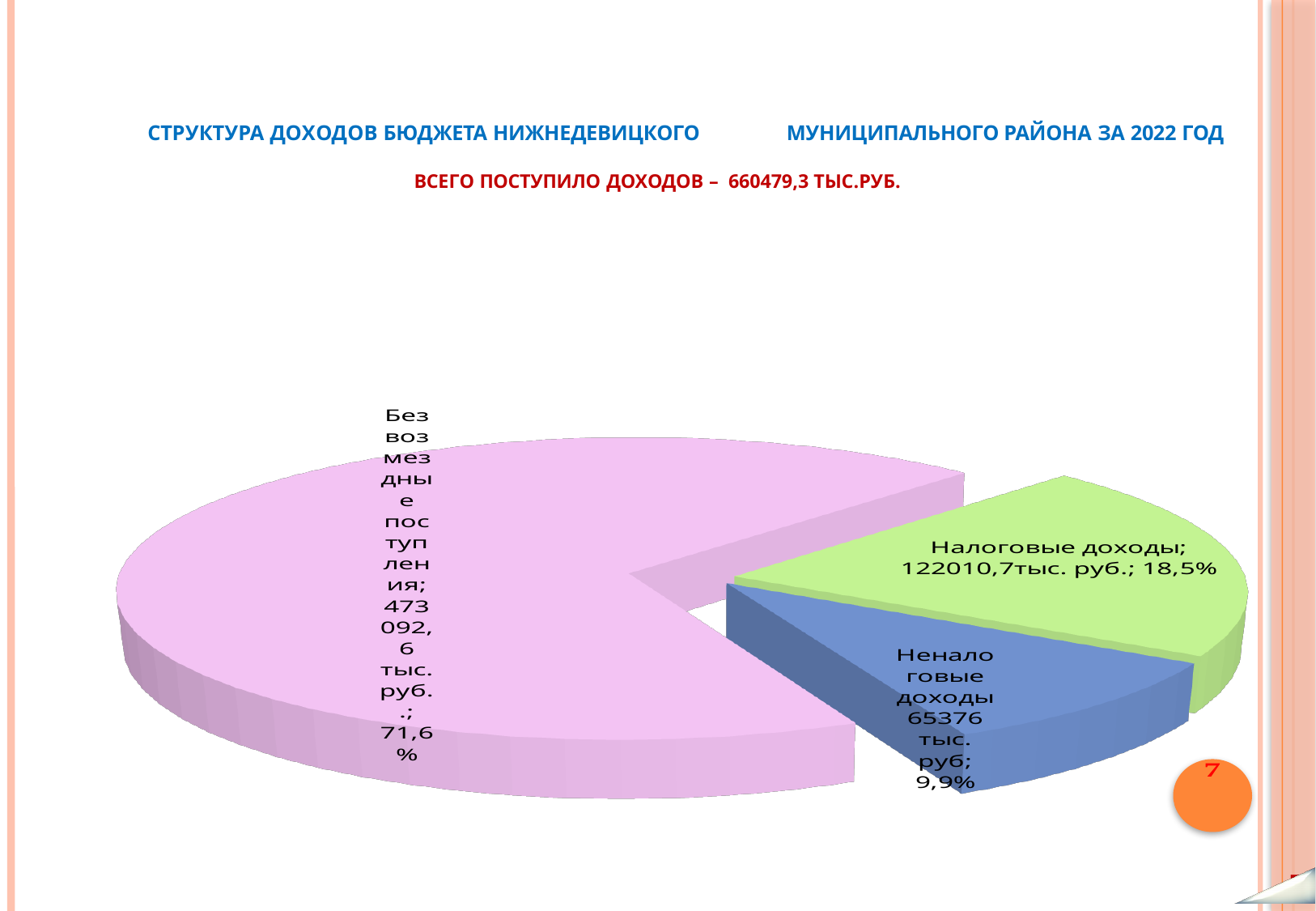
Which slice of the pie chart is the largest? Безвозмездные поступления Which slice of the pie chart is the smallest? Неналоговые доходы What kind of chart is shown on the slide? Pie chart What percentage share is shown for Налоговые доходы? 18,5% How many slices does the pie chart have? 3 What is the value shown for Налоговые доходы? 122010,7 тыс. руб. What percentage share is shown for Неналоговые доходы? 9,9% What percentage share is shown for Безвозмездные поступления? 71,6% What total income amount is stated on the slide? 660479,3 тыс.руб. Which is larger, Налоговые доходы or Неналоговые доходы? Налоговые доходы What is the value shown for Безвозмездные поступления? 473092,6 тыс. руб. What is the value shown for Неналоговые доходы? 65376 тыс. руб